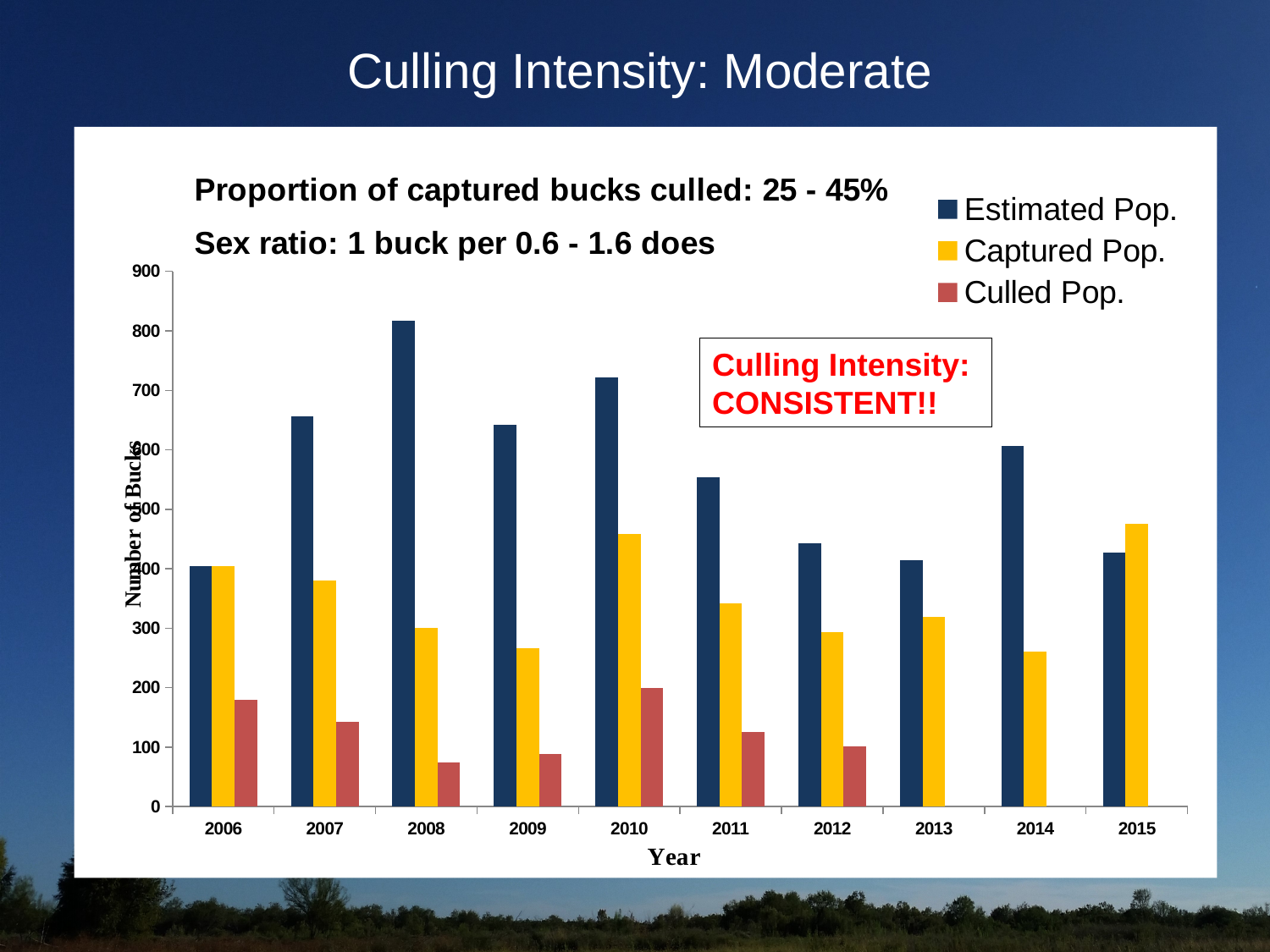
Which is larger, the Culled Pop. for 2006 or for 2008? 2006 What is the title of the y axis? Number of Bucks Is the Estimated Pop. value for 2008 greater or less than 700? greater How many series does the legend list? 3 Does the Estimated Pop. rise or fall from 2010 to 2013? fall Is the Culled Pop. value for 2008 greater or less than 100? less Which is larger, the Estimated Pop. for 2008 or for 2010? 2008 What kind of chart is shown on the slide? bar chart In which year is the Estimated Pop. highest? 2008 Is the Captured Pop. value for 2010 greater or less than 500? less How many years are shown on the x axis? 10